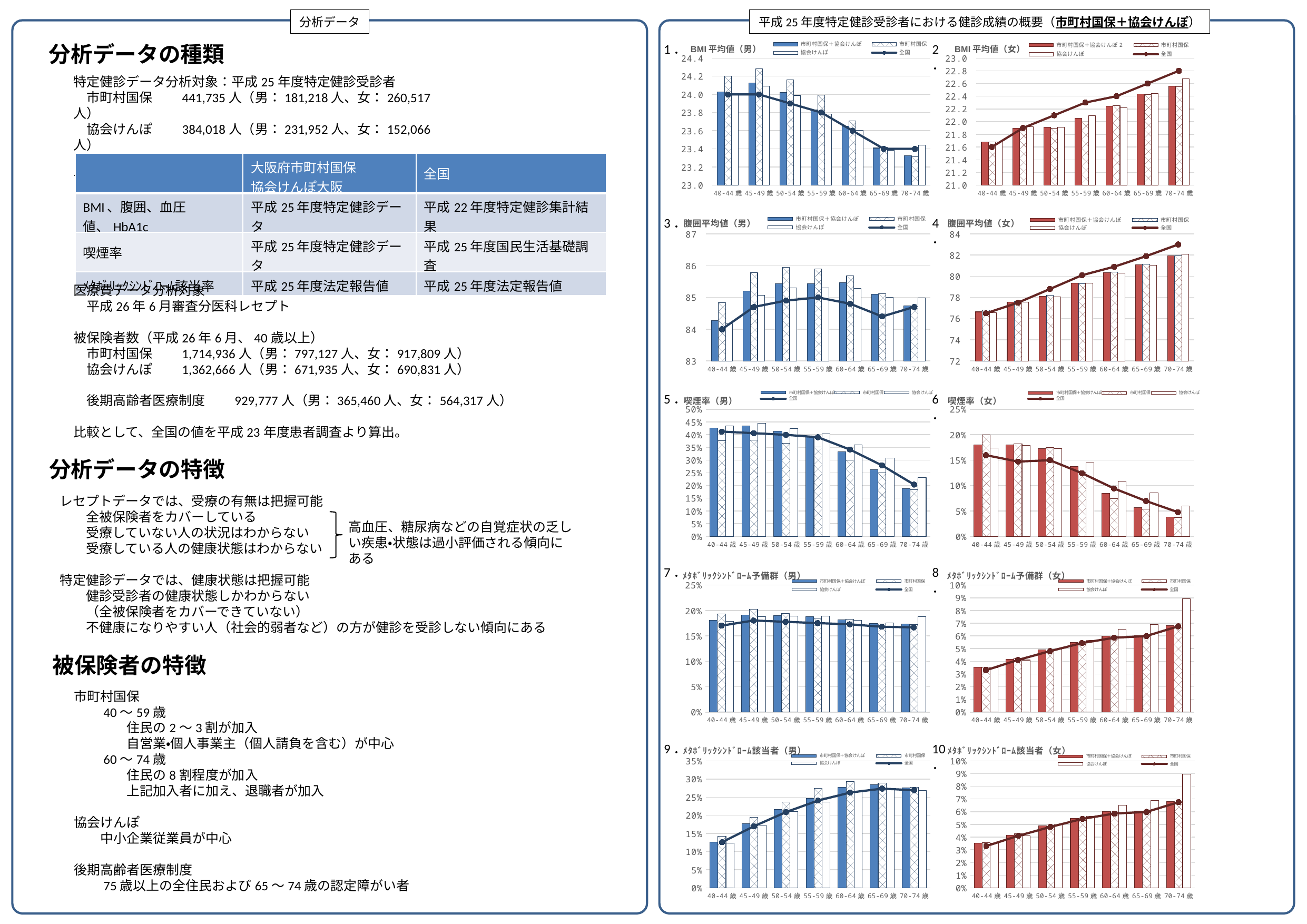
In the chart titled 腹囲平均値（女）, is the 全国 value for 70-74歳 greater or less than 82? greater In the chart titled メタボリックシンドローム該当者（男）, is the 市町村国保＋協会けんぽ value for 40-44歳 greater or less than 15%? less In the chart titled 喫煙率（女）, is the 市町村国保＋協会けんぽ value for 70-74歳 greater or less than 5%? less In the chart titled 喫煙率（男）, which age group has the lowest 市町村国保＋協会けんぽ bar? 70-74歳 In the chart titled メタボリックシンドローム該当者（女）, which age group has the highest 市町村国保 bar? 70-74歳 In the chart titled BMI平均値（男）, how many age groups are shown on the x axis? 7 In the chart titled 喫煙率（男）, do the 市町村国保＋協会けんぽ bars rise or fall as age increases along the x axis? Fall In the chart titled BMI平均値（女）, which is larger for the 全国 line: the value for 40-44歳 or the value for 70-74歳? 70-74歳 In the chart titled BMI平均値（女）, does the 全国 line rise or fall as age increases along the x axis? Rise What kind of chart is the one titled 喫煙率（男）? Bar chart with a line In the chart titled BMI平均値（男）, how many series does the legend list? 4